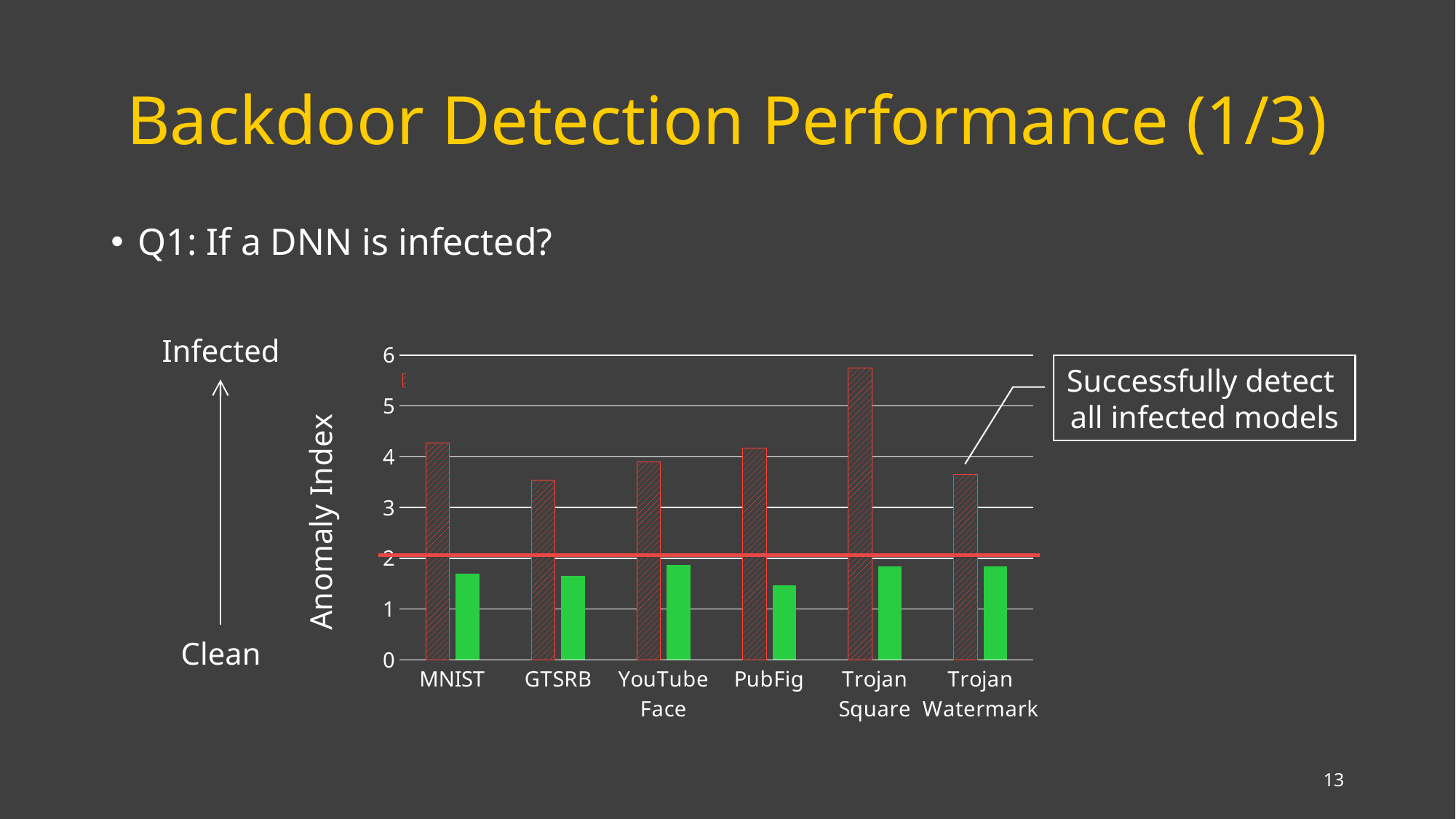
What is the label on the y axis of the chart? Anomaly Index Which is taller: the hatched (infected) bar for YouTube Face or the hatched (infected) bar for GTSRB? YouTube Face Is the green (clean) bar for PubFig greater or less than 2? less Which category has the tallest hatched (infected) bar? Trojan Square Is the hatched (infected) bar for GTSRB greater or less than 4? less Which is taller: the hatched (infected) bar for Trojan Square or the hatched (infected) bar for MNIST? Trojan Square How many categories are shown along the x axis of the chart? 6 Is the hatched (infected) bar for Trojan Watermark greater or less than 3? greater Which category has the shortest green (clean) bar? PubFig What kind of chart is shown on the slide? bar chart